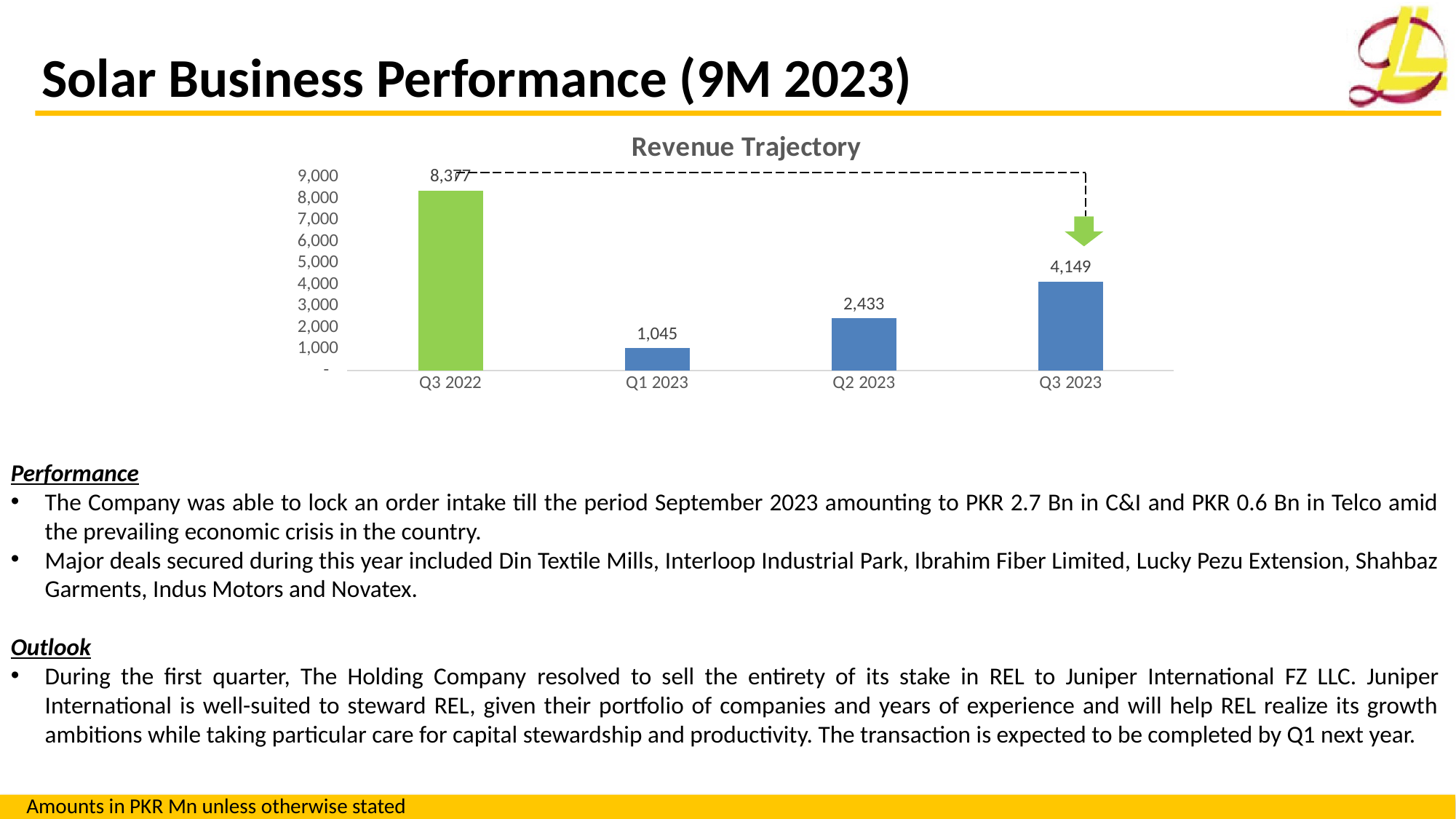
What is the difference between the Q2 2023 and Q1 2023 values in the Revenue Trajectory chart? 1,388 Is the value for Q3 2022 in the Revenue Trajectory chart greater or less than 8,000? greater What is the value for Q1 2023 in the Revenue Trajectory chart? 1,045 Which quarter has the lowest revenue in the Revenue Trajectory chart? Q1 2023 Do the values rise or fall from Q1 2023 to Q3 2023 in the Revenue Trajectory chart? Rise What is the value for Q2 2023 in the Revenue Trajectory chart? 2,433 What is the value for Q3 2023 in the Revenue Trajectory chart? 4,149 Which is larger in the Revenue Trajectory chart, Q2 2023 or Q3 2023? Q3 2023 How many quarters are shown in the Revenue Trajectory chart? 4 Which quarter has the highest revenue in the Revenue Trajectory chart? Q3 2022 What kind of chart is the Revenue Trajectory chart? Bar chart What is the difference between the Q3 2023 and Q2 2023 values in the Revenue Trajectory chart? 1,716